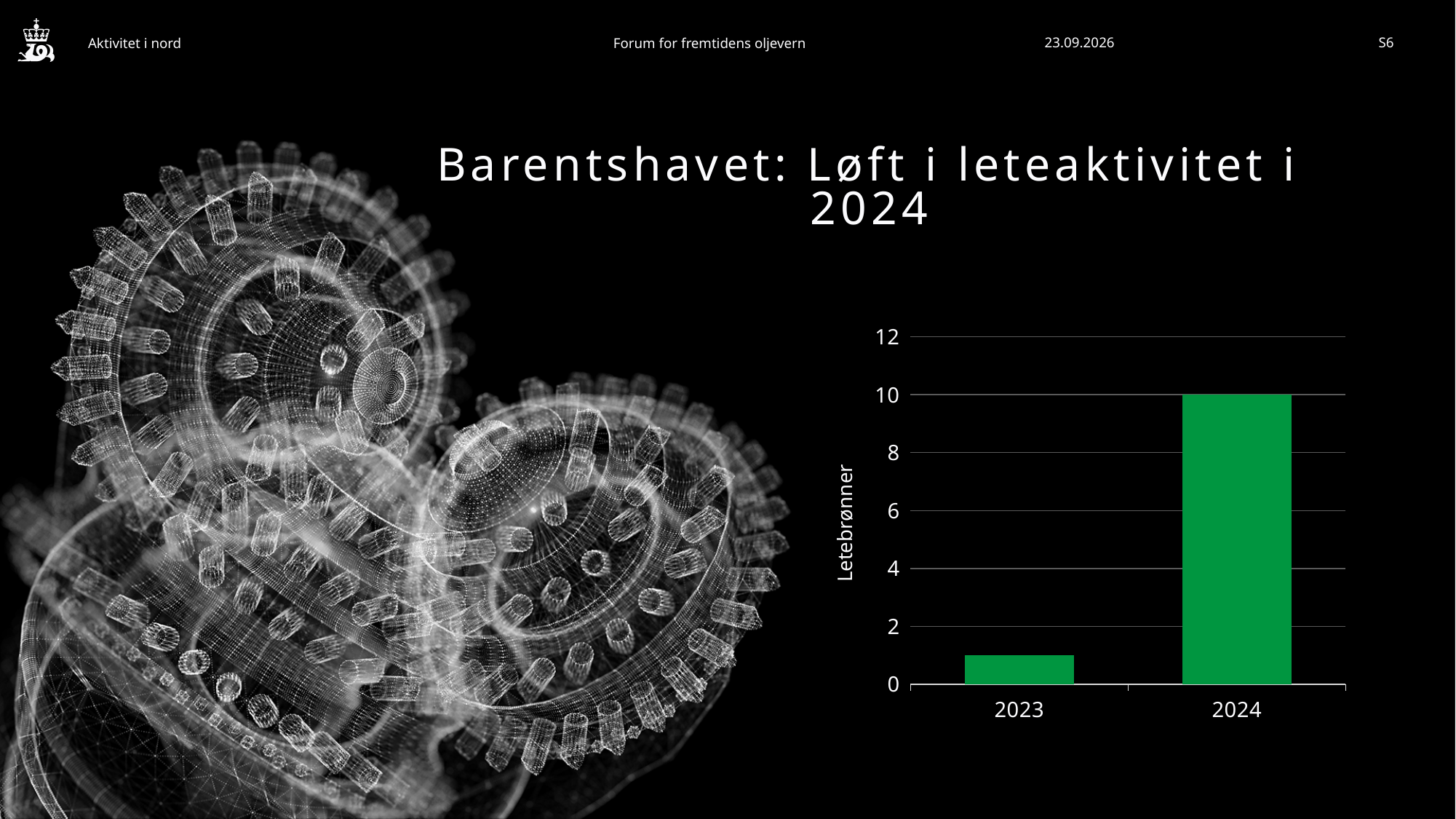
Is the value for 2024 greater or less than 8? greater What is the highest value shown on the y axis of the chart? 12 What kind of chart is shown on the slide? bar chart Which year has the highest value in the chart? 2024 Which year has the lowest value in the chart? 2023 What is the label on the y axis of the chart? Letebrønner Which is larger, the value for 2023 or the value for 2024? 2024 Do the values rise or fall from 2023 to 2024? rise What is the value for 2024 in the chart? 10 Is the value for 2023 greater or less than 2? less How many categories are shown on the x axis of the chart? 2